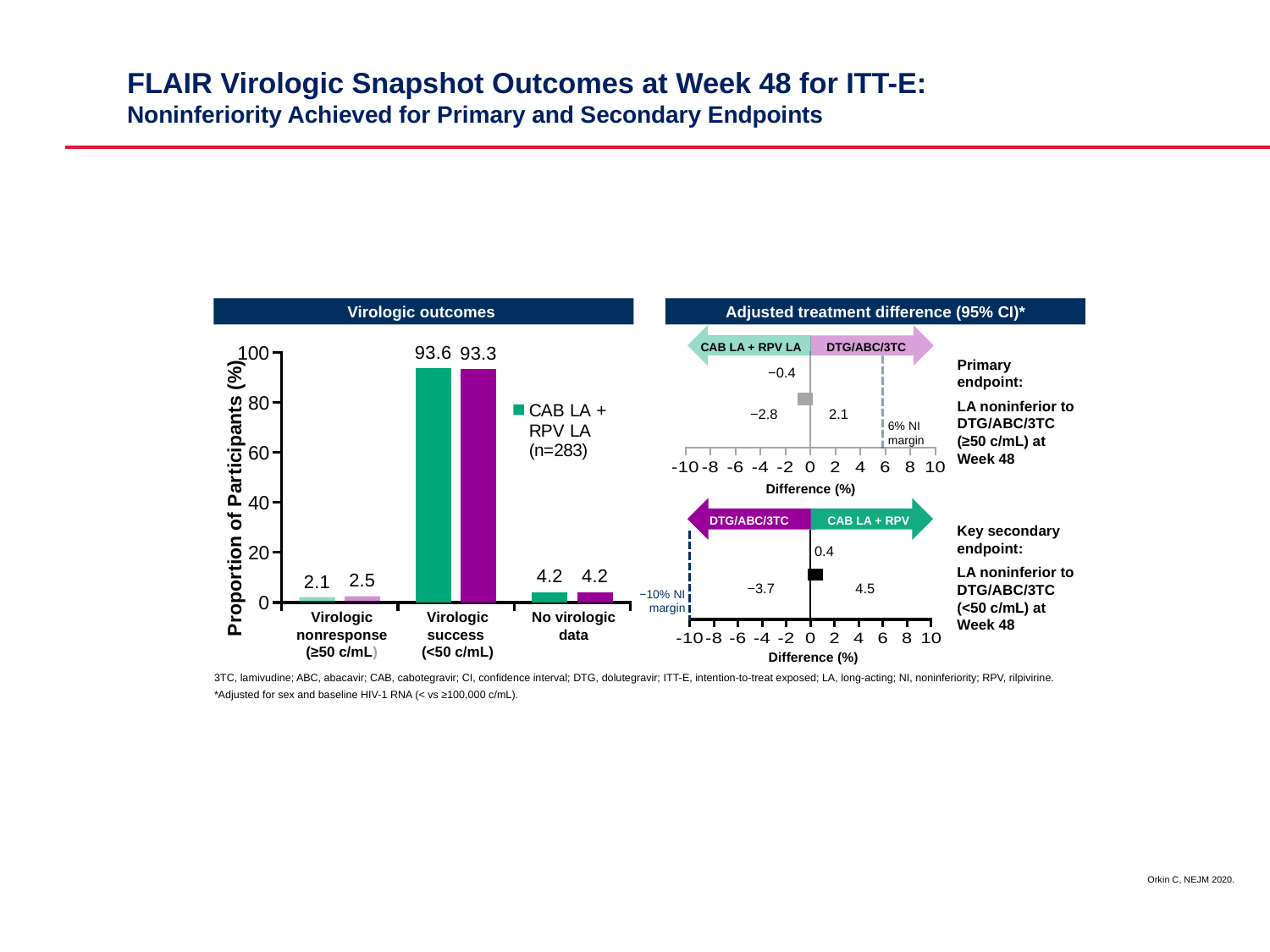
In the Virologic outcomes chart, which category has the highest value for CAB LA + RPV LA? Virologic success (<50 c/mL) In the Virologic outcomes chart, what is the value for No virologic data for CAB LA + RPV LA? 4.2 In the Virologic outcomes chart, which category has the lowest value for CAB LA + RPV LA? Virologic nonresponse (≥50 c/mL) In the Adjusted treatment difference chart, what is the upper 95% CI limit for the key secondary endpoint? 4.5 In the Virologic outcomes chart, how many categories are shown on the x axis? 3 In the Adjusted treatment difference chart, what is the point estimate for the primary endpoint? −0.4 What type of chart is the Virologic outcomes chart? Bar chart In the Virologic outcomes chart, what is the virologic success value for CAB LA + RPV LA? 93.6 In the Virologic outcomes chart, what is the value of the purple bar for virologic success? 93.3 In the Virologic outcomes chart, what is the virologic nonresponse value for CAB LA + RPV LA? 2.1 In the Virologic outcomes chart, what is the value of the purple bar for virologic nonresponse? 2.5 In the Virologic outcomes chart, what is the difference between the green and purple bars for virologic success? 0.3